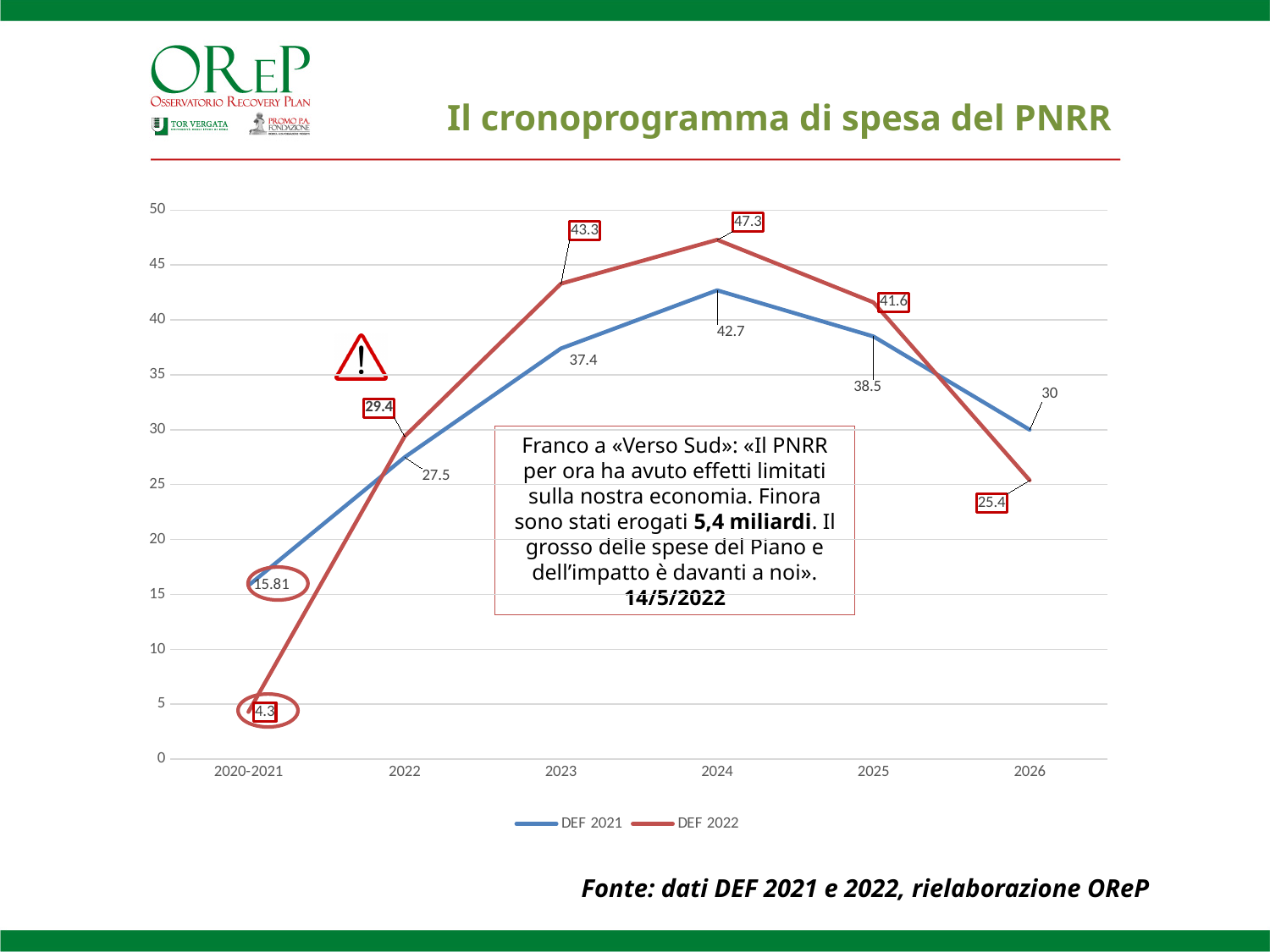
Does the DEF 2022 series rise or fall from 2024 to 2026? fall In which year is the DEF 2022 series at its lowest value? 2020-2021 For 2026, which series has the larger value, DEF 2021 or DEF 2022? DEF 2021 What is the difference between the DEF 2022 and DEF 2021 values for 2023? 5.9 In which year does the DEF 2021 series reach its highest value? 2024 How many series does the legend list? 2 How many categories are shown on the x axis? 6 What is the DEF 2022 value for 2024? 47.3 What is the DEF 2022 value for 2026? 25.4 What is the DEF 2021 value for 2020-2021? 15.81 What is the title of the slide's chart? Il cronoprogramma di spesa del PNRR What type of chart is shown on the slide? line chart